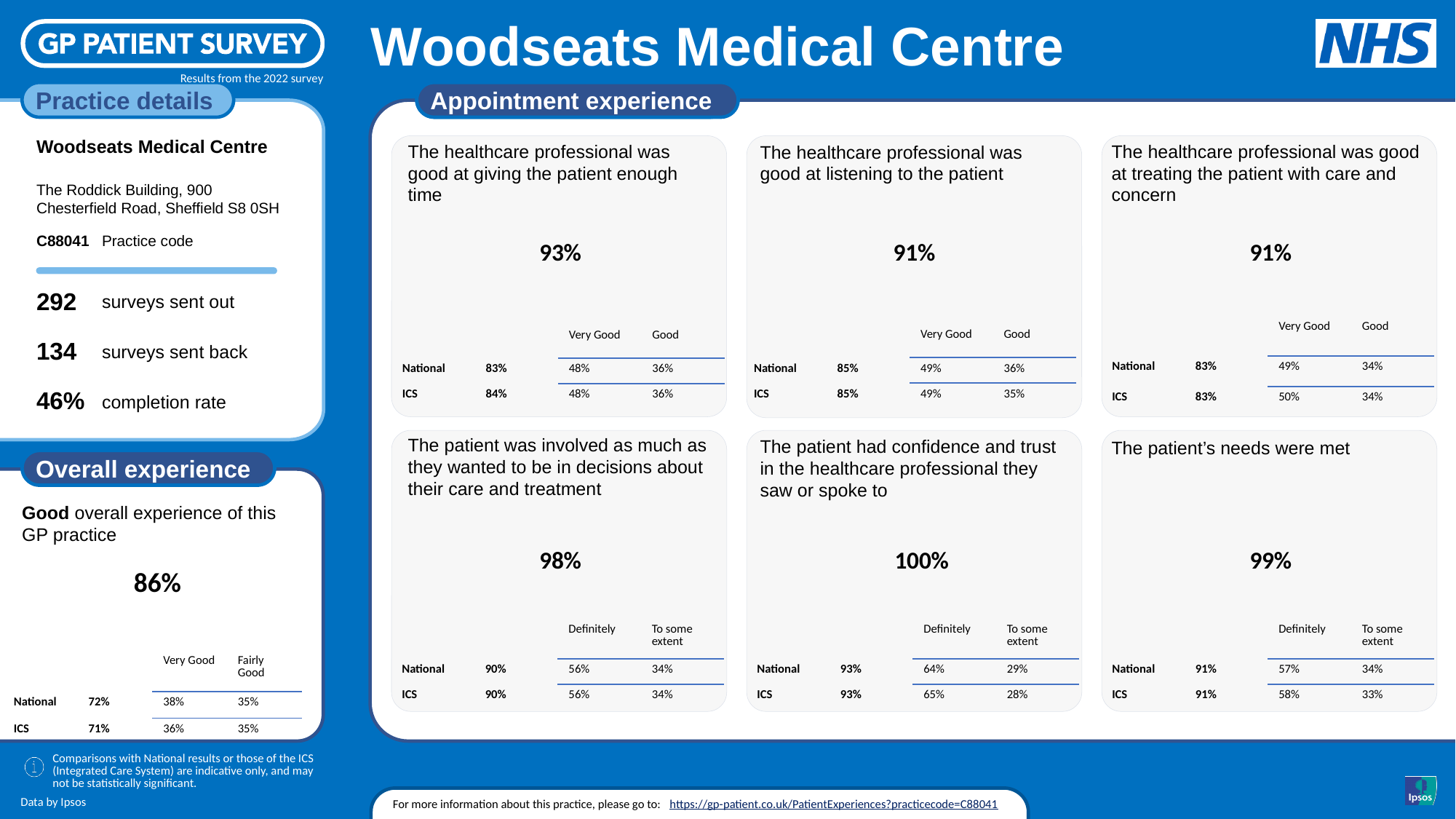
In the 'Appointment experience' section, which measure has the lowest practice percentage? The healthcare professional was good at listening to the patient (91%) and good at treating the patient with care and concern (91%) In the 'Practice details' panel, what is the completion rate? 46% In the 'Appointment experience' section, what percentage said the healthcare professional was good at giving the patient enough time? 93% In the 'Appointment experience' section, which of the six measures has the highest practice percentage? The patient had confidence and trust in the healthcare professional they saw or spoke to In the 'Appointment experience' section, for 'good at listening to the patient', what is the ICS 'Very Good' percentage? 49% In the 'Overall experience' panel, what is the ICS 'Very Good' percentage? 36% In the 'Appointment experience' section, what is the practice's figure for the patient having confidence and trust in the healthcare professional? 100% In the 'Appointment experience' section, is the practice's figure for 'involved as much as they wanted in decisions' higher or lower than the National figure? Higher How many measures are shown in the 'Appointment experience' section? 6 In the 'Overall experience' panel, what percentage of patients reported a good overall experience of this GP practice? 86% In the 'Appointment experience' section, what is the difference between the practice's 'needs were met' figure and the National figure for that measure? 8 percentage points In the 'Overall experience' panel, what is the National figure for good overall experience? 72%